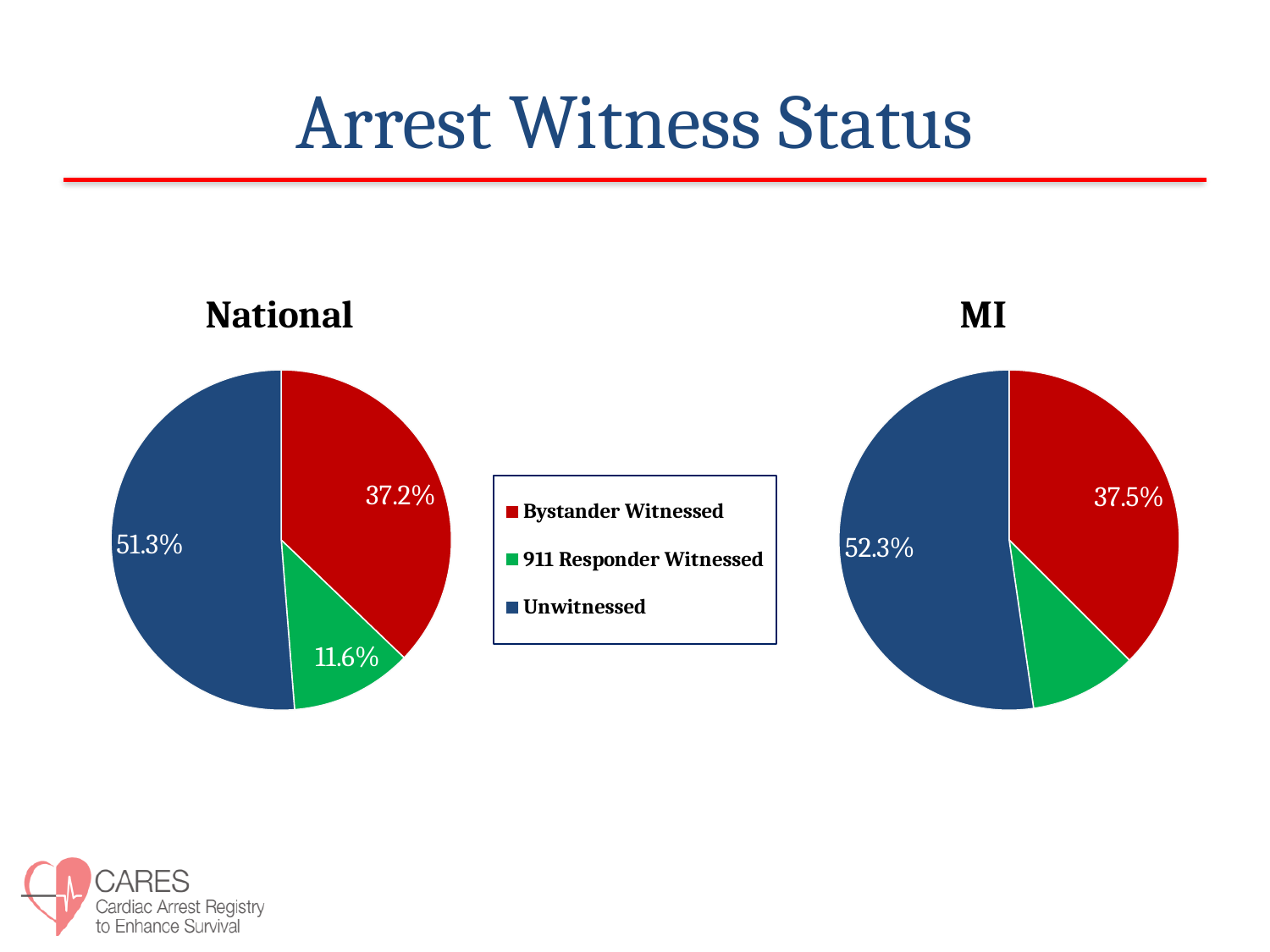
In the National pie chart, what share is Bystander Witnessed? 37.2% In the National pie chart, which category has the largest share? Unwitnessed In the MI pie chart, which category has the smallest share? 911 Responder Witnessed In the National pie chart, what is the difference between the Unwitnessed share and the Bystander Witnessed share? 14.1% In the National pie chart, which category has the smallest share? 911 Responder Witnessed What type of chart is used for the National and MI data? Pie chart In the National pie chart, what share is 911 Responder Witnessed? 11.6% In the MI pie chart, what share is Bystander Witnessed? 37.5% In the National pie chart, what share is Unwitnessed? 51.3% In the MI pie chart, what share is Unwitnessed? 52.3% Which is larger: the Unwitnessed share in the MI chart or the Unwitnessed share in the National chart? MI How many categories does the legend list for the pie charts? 3